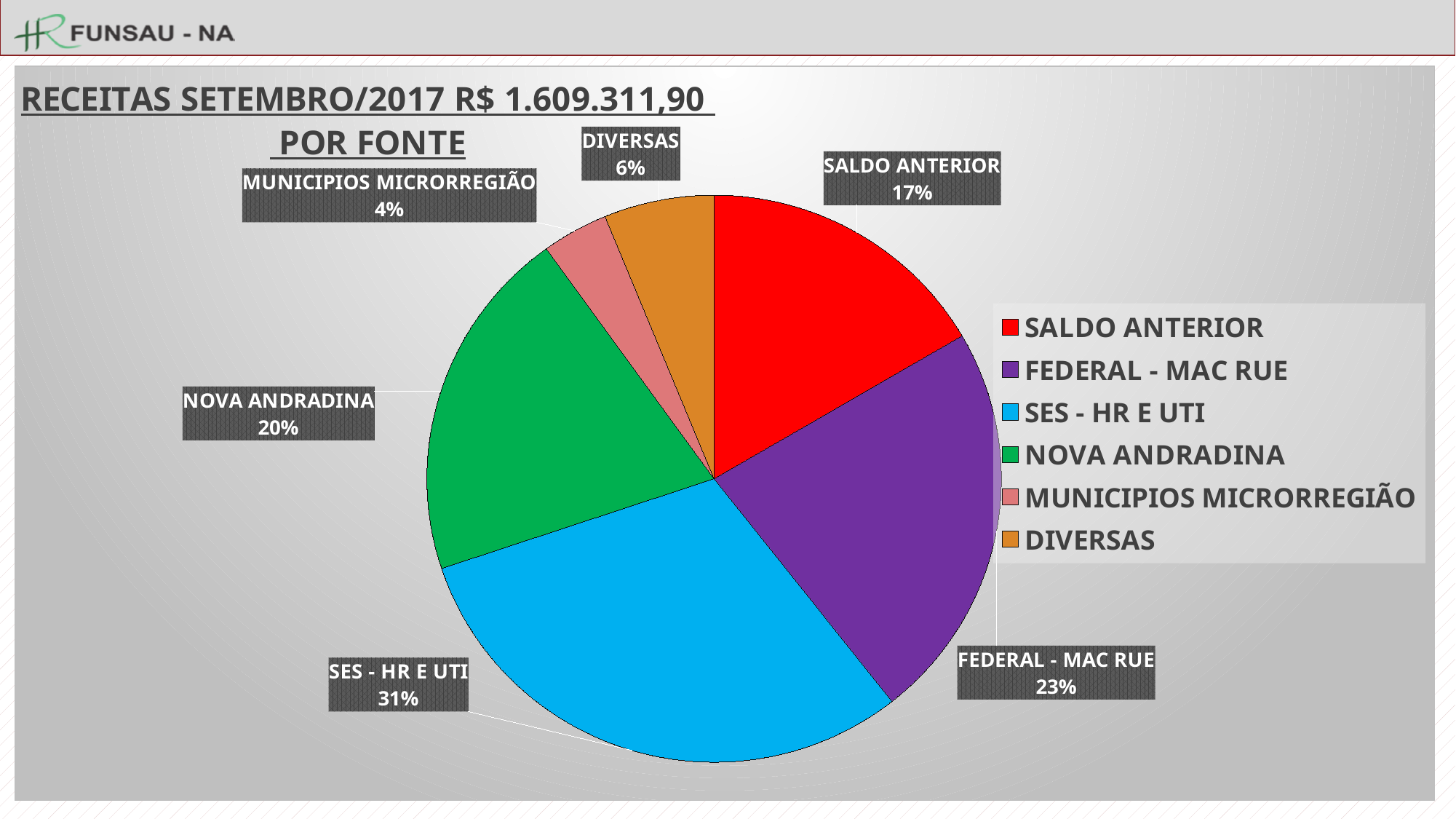
Which source has the largest share of the pie? SES - HR E UTI Which source has the smallest share of the pie? MUNICIPIOS MICRORREGIÃO What kind of chart is shown on the slide? pie chart What percentage is shown for FEDERAL - MAC RUE? 23% Which is larger, the share for FEDERAL - MAC RUE or the share for SALDO ANTERIOR? FEDERAL - MAC RUE How many entries does the legend list? 6 What is the difference in percentage points between SES - HR E UTI and NOVA ANDRADINA? 11 What share of the pie does SES - HR E UTI represent? 31% What percentage is shown for SALDO ANTERIOR? 17% What colour is the DIVERSAS slice? orange How many slices does the pie chart have? 6 What percentage is shown for MUNICIPIOS MICRORREGIÃO? 4%